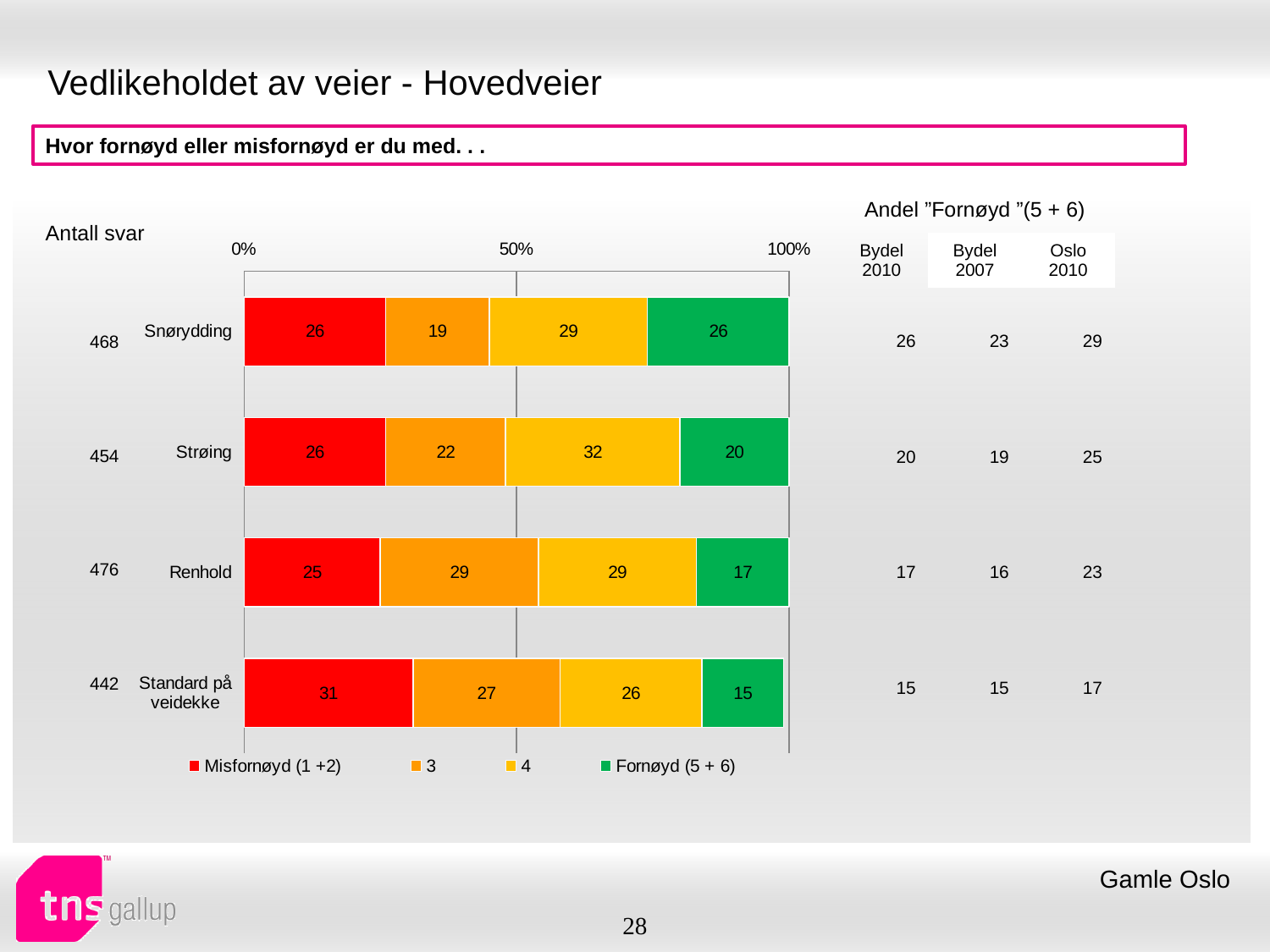
What is the value of the '3' segment for Renhold? 29 Which category has the highest 'Fornøyd (5 + 6)' value? Snørydding Which category has the lowest 'Fornøyd (5 + 6)' value? Standard på veidekke What kind of chart is shown on the slide? Stacked bar chart What is the value of the 'Misfornøyd (1 +2)' segment for Standard på veidekke? 31 How many categories are plotted in the chart? 4 What is the difference between the 'Misfornøyd (1 +2)' values for Standard på veidekke and Renhold? 6 What is the value of the 'Fornøyd (5 + 6)' segment for Snørydding? 26 What is the value of the '4' segment for Strøing? 32 What colour represents the 'Fornøyd (5 + 6)' series in the chart? Green How many series does the legend list? 4 Which is larger: the '3' segment for Strøing or the '3' segment for Snørydding? Strøing